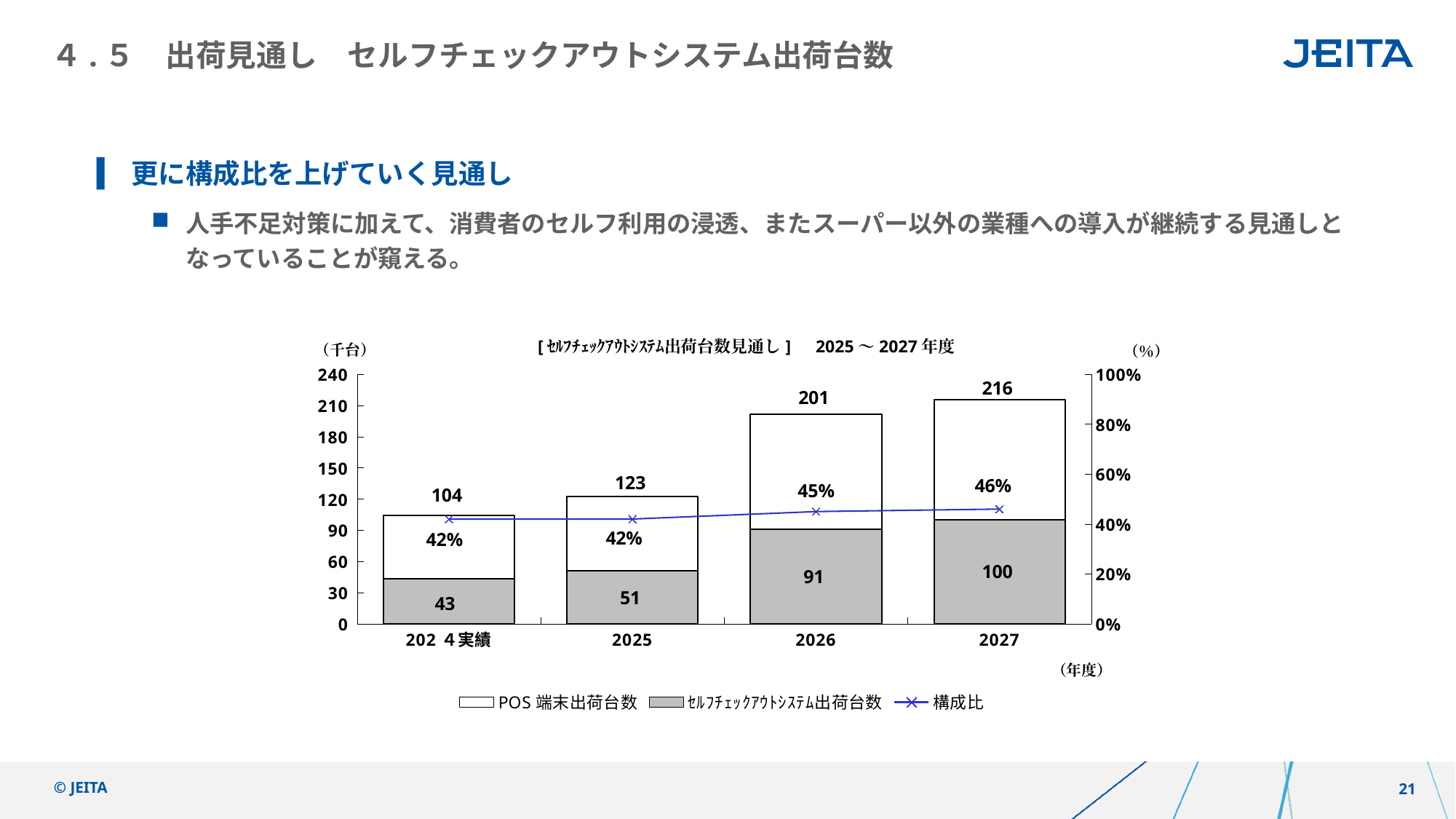
What is the value of POS 端末出荷台数 for 2027? 216 What is the value of セルフチェックアウトシステム出荷台数 for 2026? 91 How many years are shown on the x axis of the chart? 4 What is the difference in POS 端末出荷台数 between 2027 and 2026? 15 Does the 構成比 line rise or fall from 2024実績 to 2027? Rise What kind of chart is shown on the slide? Bar chart with a line What is the 構成比 value for 2025? 42% Which year has the larger セルフチェックアウトシステム出荷台数, 2025 or 2026? 2026 What is the difference in セルフチェックアウトシステム出荷台数 between 2025 and 2024実績? 8 Which year has the highest セルフチェックアウトシステム出荷台数? 2027 Which year has the lowest POS 端末出荷台数? 2024実績 How many series does the legend list? 3